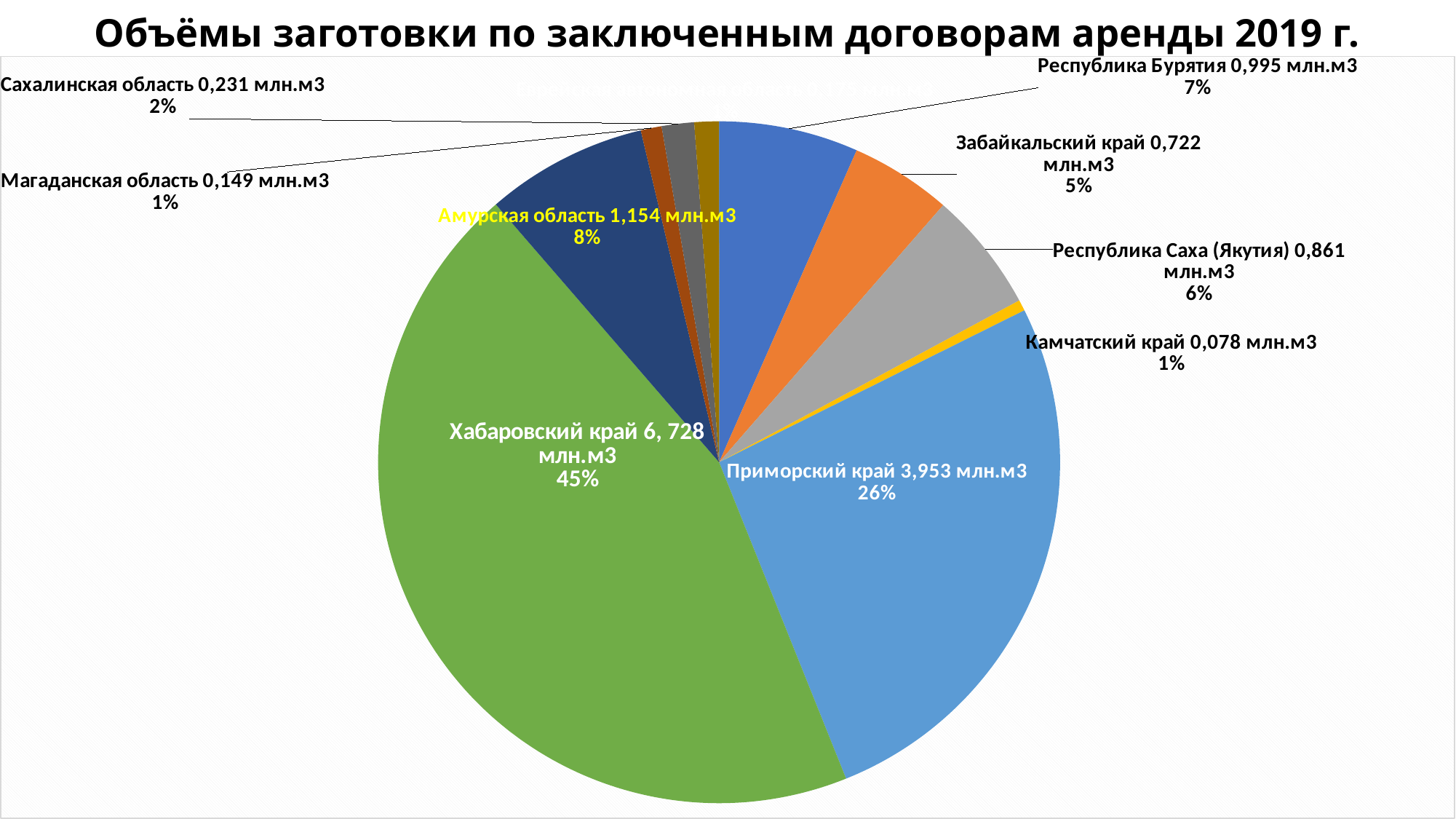
What is the harvest volume for Амурская область? 1,154 млн.м3 Which region has the largest slice of the pie? Хабаровский край What is the difference in volume between Хабаровский край and Приморский край? 2,775 млн.м3 What share of the pie does Республика Саха (Якутия) account for? 6% What is the harvest volume for Республика Бурятия? 0,995 млн.м3 What is the title of the chart? Объёмы заготовки по заключенным договорам аренды 2019 г. What is the harvest volume for Приморский край? 3,953 млн.м3 What is the harvest volume for Хабаровский край? 6, 728 млн.м3 What share of the pie does Приморский край account for? 26% Which is larger, the volume for Забайкальский край or for Республика Саха (Якутия)? Республика Саха (Якутия) What kind of chart is shown on the slide? pie chart